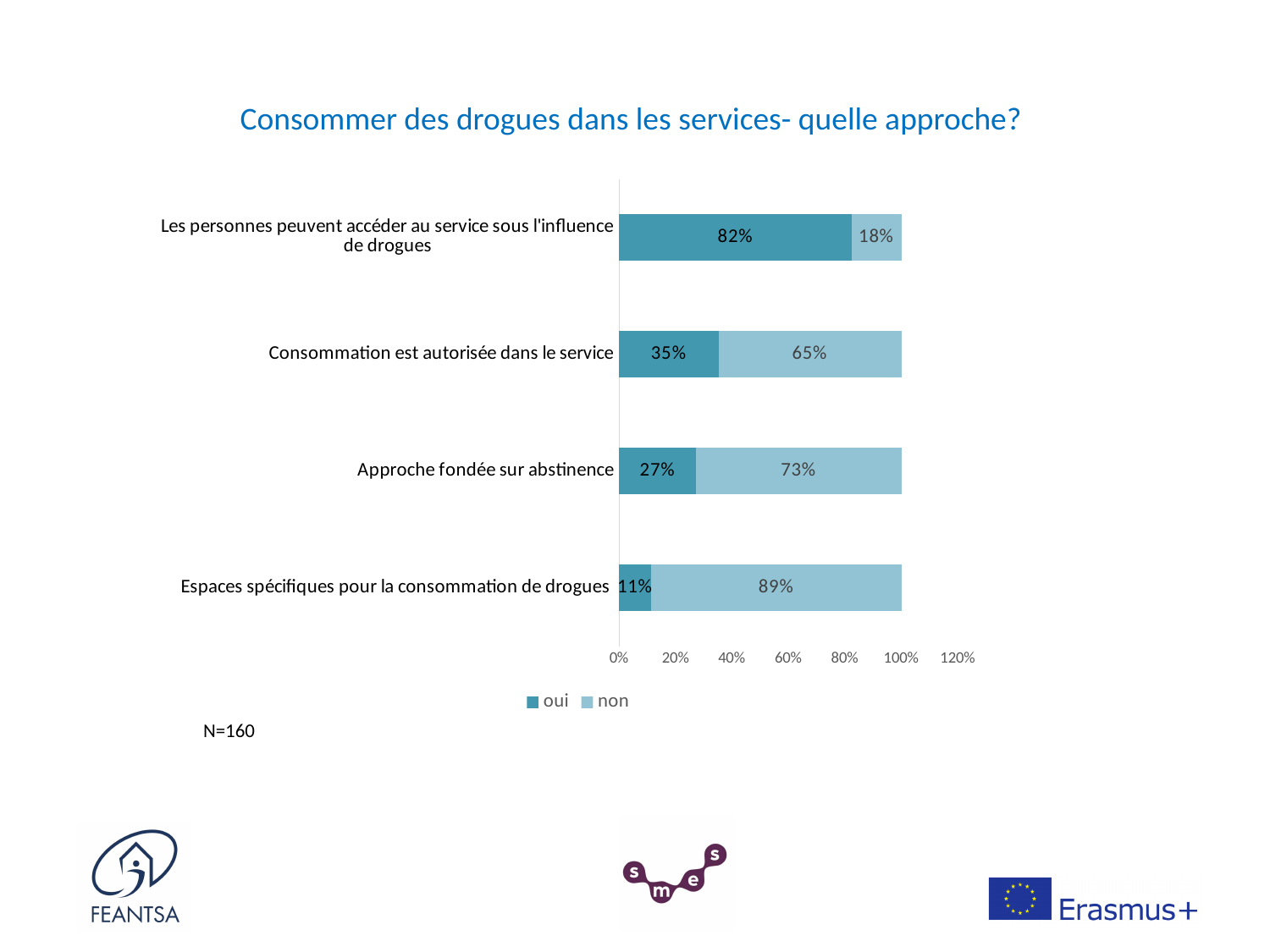
What is the title of the chart? Consommer des drogues dans les services- quelle approche? How many categories are shown in the chart? 4 What is the 'oui' value for 'Consommation est autorisée dans le service'? 35% Which is larger: the 'oui' value for 'Consommation est autorisée dans le service' or the 'oui' value for 'Approche fondée sur abstinence'? Consommation est autorisée dans le service How many series does the legend list? 2 Which category has the lowest 'oui' value? Espaces spécifiques pour la consommation de drogues Which category has the highest 'oui' value? Les personnes peuvent accéder au service sous l'influence de drogues What is the 'oui' value for 'Espaces spécifiques pour la consommation de drogues'? 11% What is the 'non' value for 'Les personnes peuvent accéder au service sous l'influence de drogues'? 18% What is the difference between the 'non' values for 'Espaces spécifiques pour la consommation de drogues' and 'Consommation est autorisée dans le service'? 24% What kind of chart is shown on the slide? Stacked bar chart What is the 'non' value for 'Approche fondée sur abstinence'? 73%